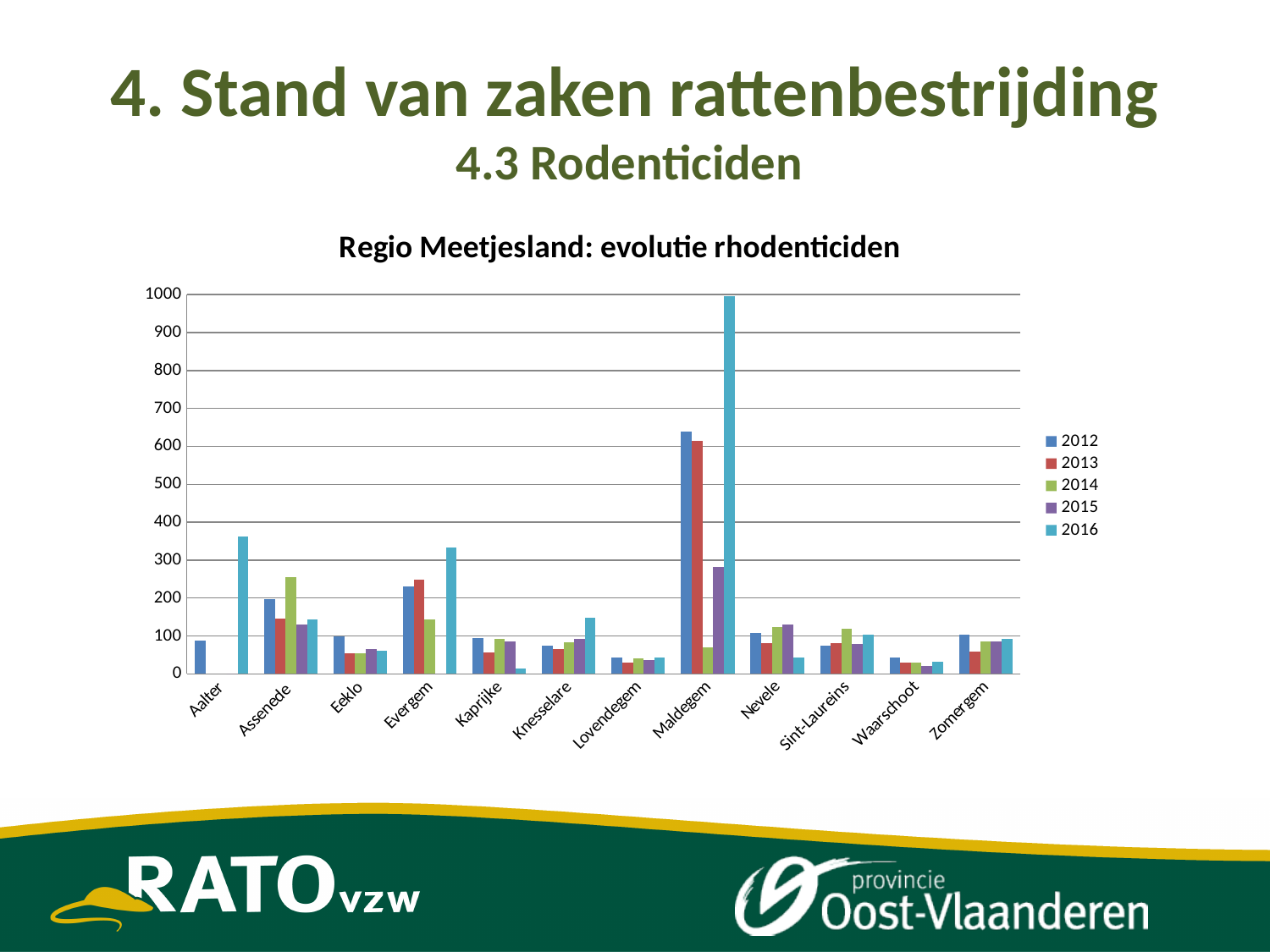
Is the 2016 value for Maldegem greater or less than 900? greater How many municipalities (categories) are shown on the x axis? 12 How many series does the legend list? 5 Which municipality has the highest 2012 bar? Maldegem Which municipality has the highest 2016 bar? Maldegem What type of chart is shown on the slide? bar chart For Evergem, which is larger: the 2013 value or the 2014 value? 2013 Which years are listed in the legend? 2012, 2013, 2014, 2015, 2016 Is the 2016 value for Aalter greater or less than 300? greater What is the title of the chart? Regio Meetjesland: evolutie rhodenticiden Is the 2012 value for Lovendegem greater or less than 100? less For Assenede, which is larger: the 2012 value or the 2014 value? 2014